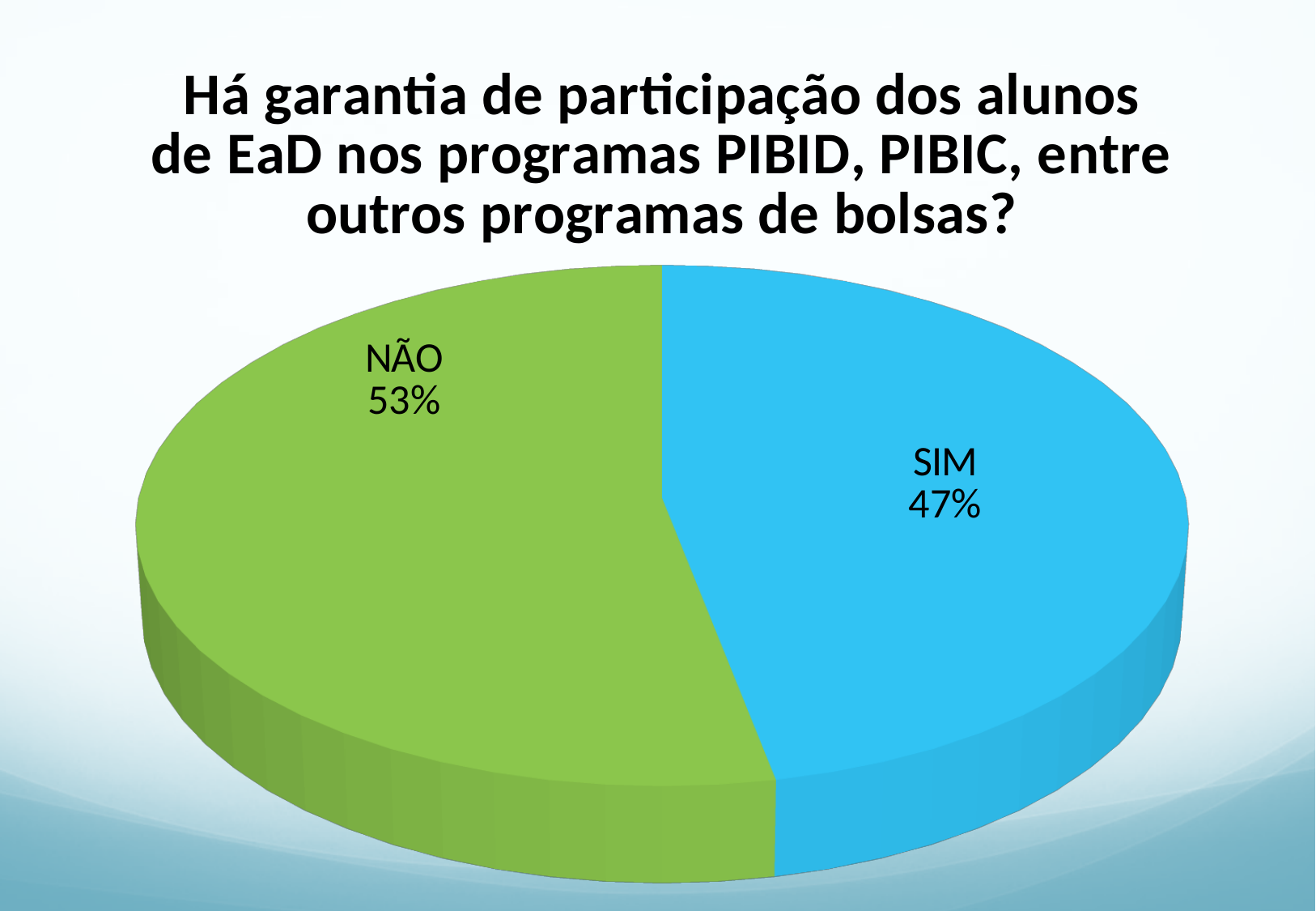
What percentage of the pie is labelled NÃO? 53% What percentage of the pie is labelled SIM? 47% Which slice is the largest? NÃO What colour is the SIM slice? Blue What colour is the NÃO slice? Green What kind of chart is shown on the slide? Pie chart What share of the pie does the SIM slice represent? 47% What is the difference in percentage points between the NÃO and SIM slices? 6 How many slices does the pie chart have? 2 Which is larger, the SIM slice or the NÃO slice? NÃO Which slice is the smallest? SIM